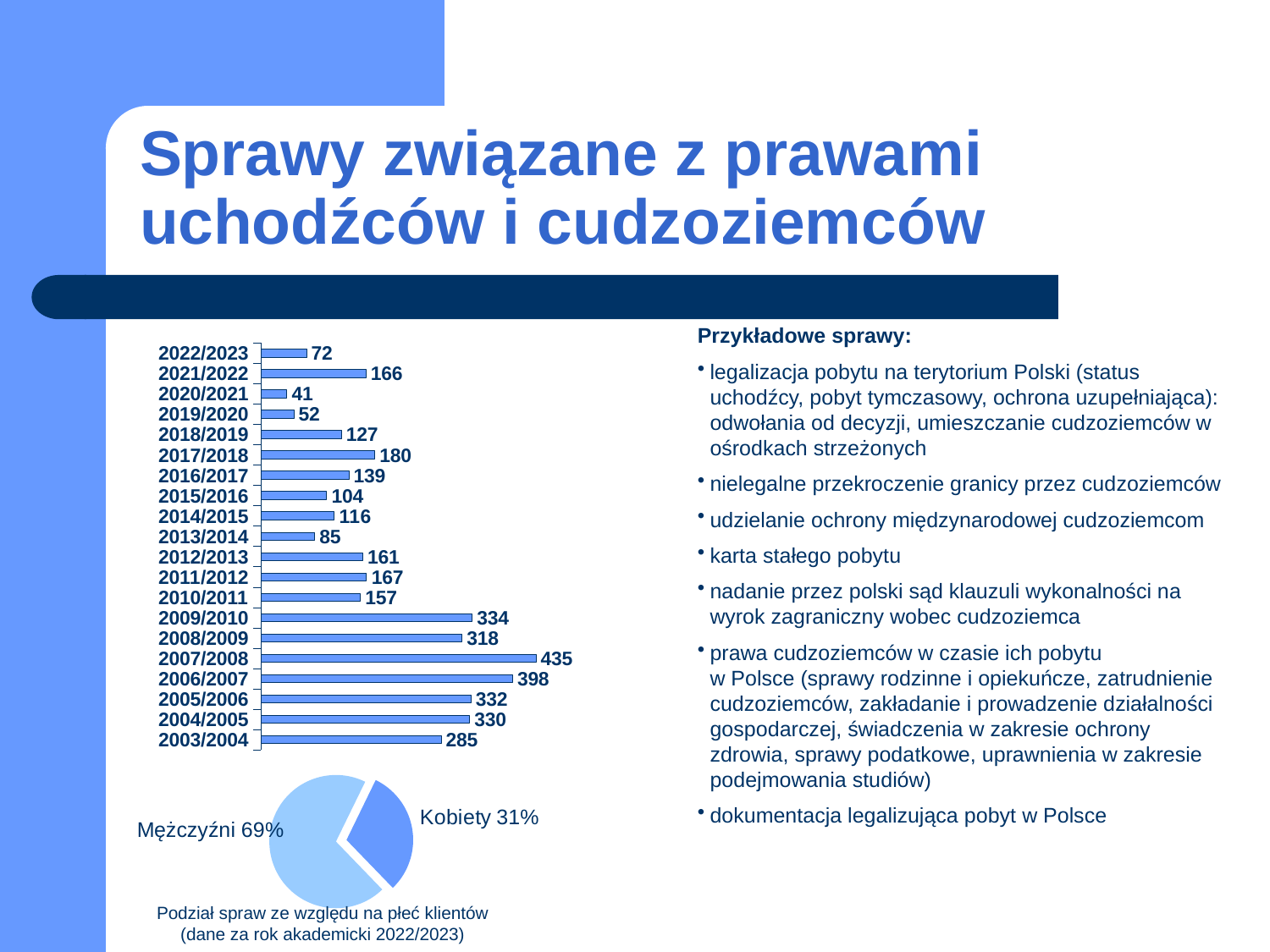
What kind of chart is the chart at the bottom left of the slide? pie chart How many academic years are shown in the bar chart? 20 In the pie chart at the bottom left, what share is labelled Mężczyźni? 69% In the pie chart at the bottom left, what share is labelled Kobiety? 31% In the bar chart, what is the value for 2013/2014? 85 In the bar chart, which academic year has the lowest value? 2020/2021 In the bar chart, which is larger, the value for 2009/2010 or the value for 2008/2009? 2009/2010 What kind of chart is the chart showing values by academic year? bar chart In the bar chart, which academic year has the highest value? 2007/2008 In the bar chart, what is the difference between the values for 2021/2022 and 2022/2023? 94 In the bar chart, what is the value for 2022/2023? 72 In the bar chart, what is the value for 2007/2008? 435